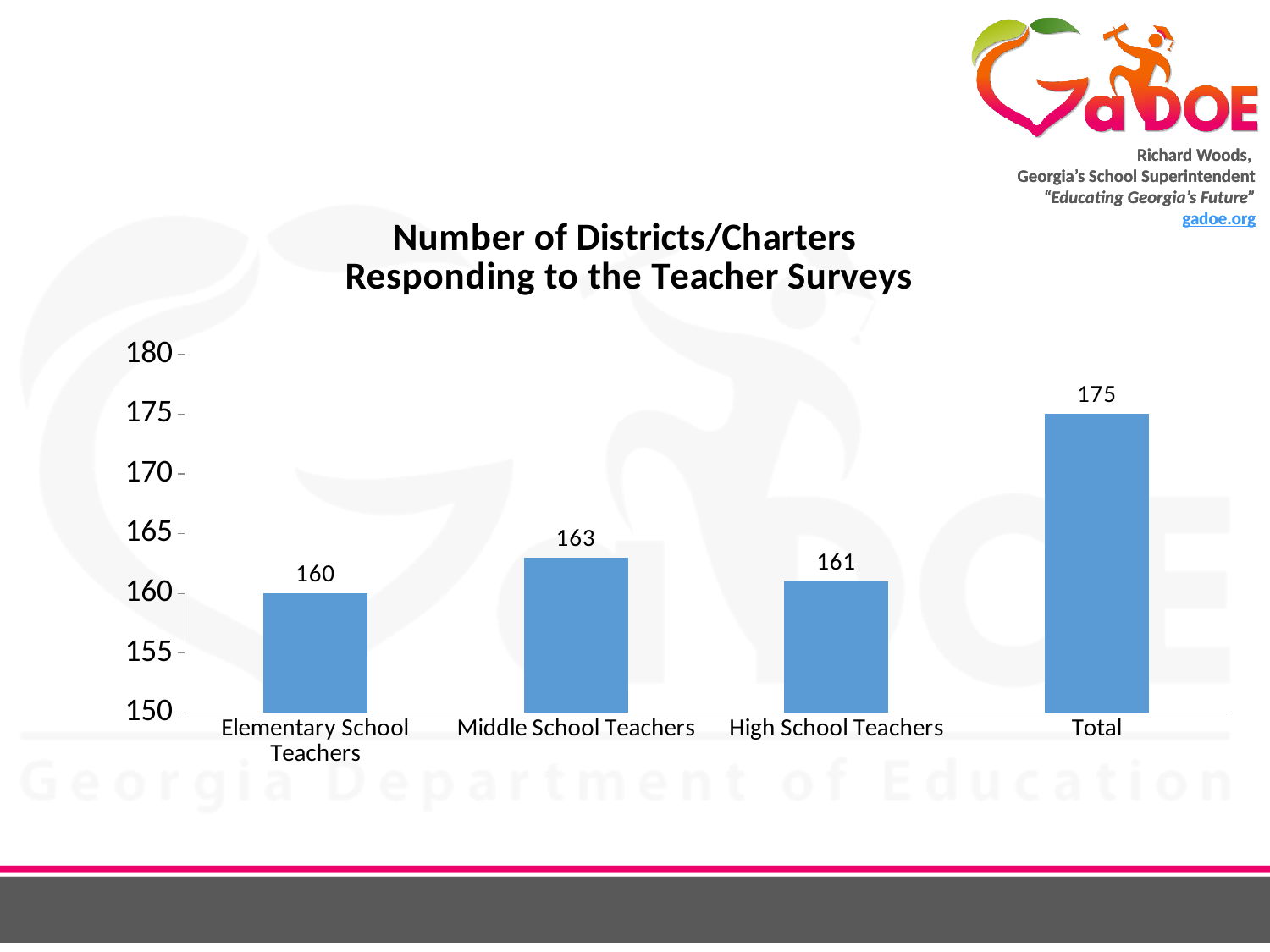
Which is larger, the value for Middle School Teachers or High School Teachers? Middle School Teachers What kind of chart is shown on the slide? Bar chart What is the difference between the Middle School Teachers and Elementary School Teachers values? 3 How many categories are shown on the x axis? 4 Is the value for Total greater or less than 170? greater Which category has the lowest value? Elementary School Teachers What is the value for Elementary School Teachers? 160 What is the value for Total? 175 What is the difference between the Total and the Middle School Teachers values? 12 Which category has the highest value? Total What is the value for High School Teachers? 161 What is the value for Middle School Teachers? 163